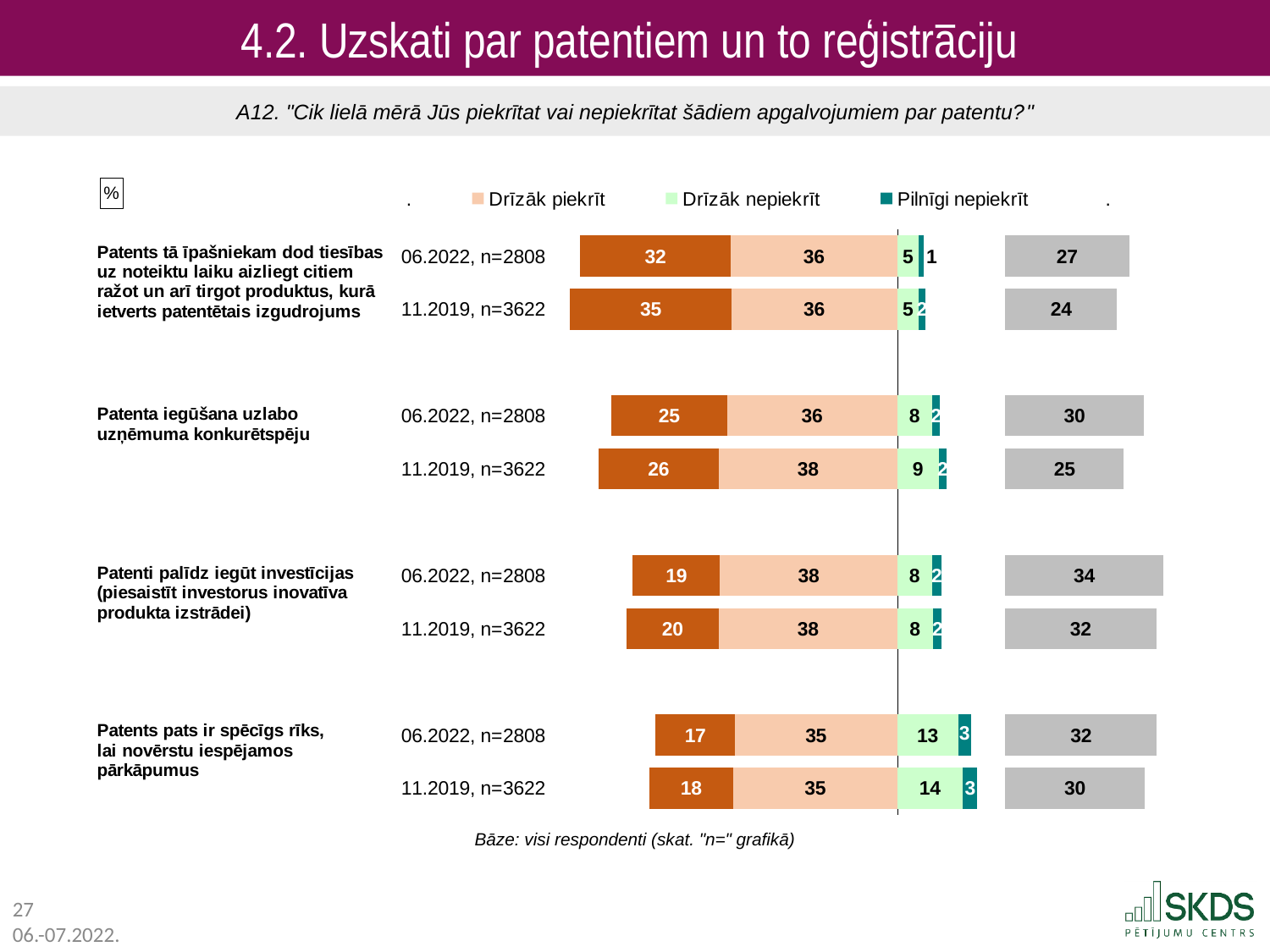
What is the 'Pilnīgi nepiekrīt' value for 'Patents pats ir spēcīgs rīks, lai novērstu iespējamos pārkāpumus' in 06.2022? 3 What is the difference between the 'Drīzāk nepiekrīt' values for 'Patents pats ir spēcīgs rīks, lai novērstu iespējamos pārkāpumus' and 'Patents tā īpašniekam dod tiesības...' in 06.2022? 8 What is the 'Drīzāk piekrīt' value for 'Patenta iegūšana uzlabo uzņēmuma konkurētspēju' in 11.2019? 38 How many statements are shown in the chart? 4 What kind of chart is shown on the slide? bar chart Which is larger: the 'Drīzāk piekrīt' value for 'Patenti palīdz iegūt investīcijas' in 06.2022 or the 'Drīzāk piekrīt' value for 'Patents pats ir spēcīgs rīks' in 06.2022? Patenti palīdz iegūt investīcijas What is the 'Drīzāk piekrīt' value for 'Patents tā īpašniekam dod tiesības uz noteiktu laiku aizliegt citiem ražot un arī tirgot produktus, kurā ietverts patentētais izgudrojums' in 06.2022? 36 Which statement has the highest 'Drīzāk nepiekrīt' value in 06.2022? Patents pats ir spēcīgs rīks, lai novērstu iespējamos pārkāpumus Which statement has the lowest 'Drīzāk nepiekrīt' value in 11.2019? Patents tā īpašniekam dod tiesības uz noteiktu laiku aizliegt citiem ražot un arī tirgot produktus, kurā ietverts patentētais izgudrojums What is the 'Drīzāk nepiekrīt' value for 'Patents pats ir spēcīgs rīks, lai novērstu iespējamos pārkāpumus' in 11.2019? 14 What is the 'Drīzāk nepiekrīt' value for 'Patenti palīdz iegūt investīcijas (piesaistīt investorus inovatīva produkta izstrādei)' in 06.2022? 8 What is the survey question shown above the chart? A12. "Cik lielā mērā Jūs piekrītat vai nepiekrītat šādiem apgalvojumiem par patentu?"